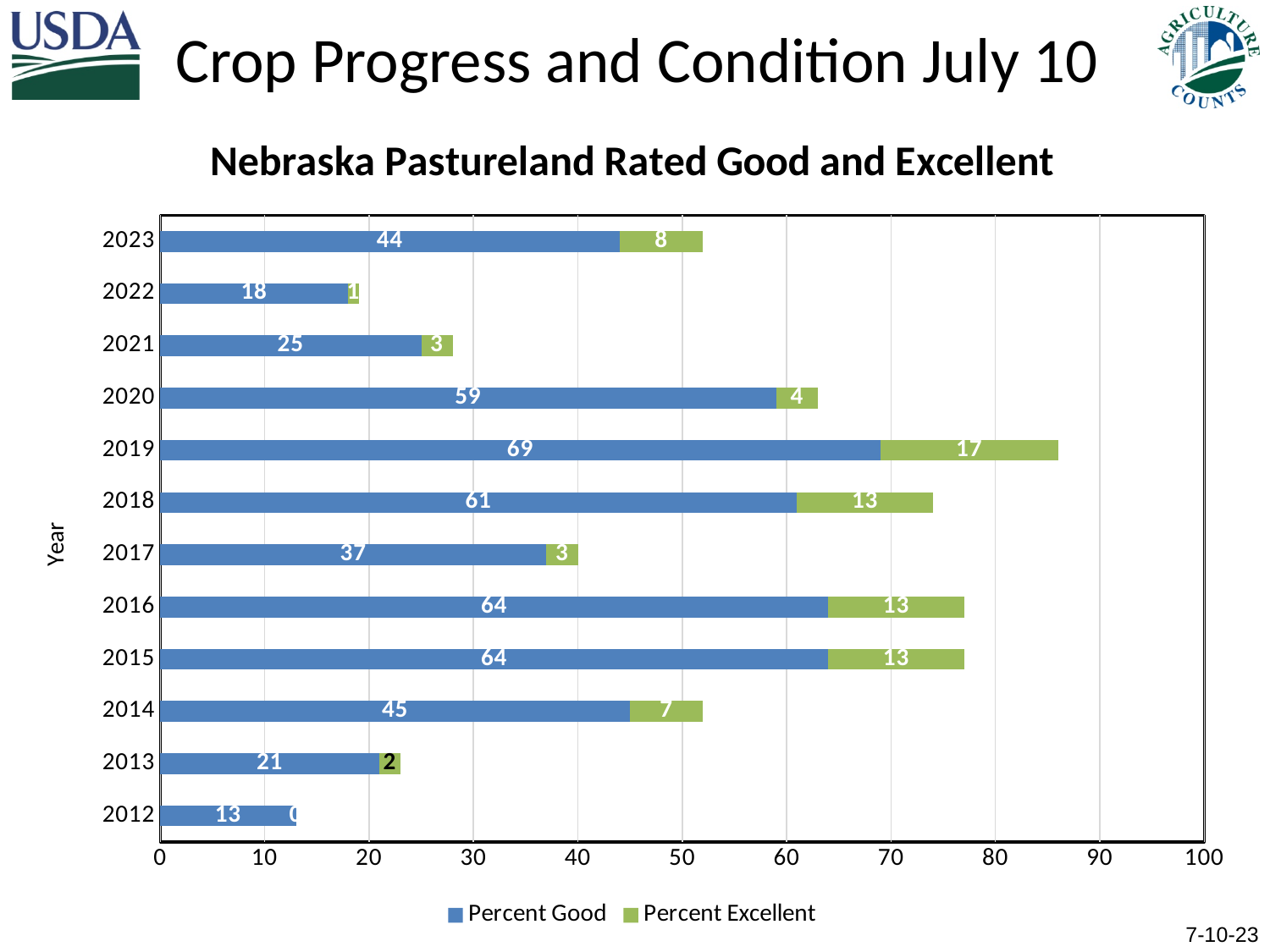
What kind of chart is shown on the slide? Stacked bar chart Which year has the highest Percent Good value? 2019 What is the total of the stacked bar for 2019 (Percent Good plus Percent Excellent)? 86 What is the difference between the Percent Good values for 2020 and 2021? 34 What is the Percent Good value for 2012? 13 How many series does the legend list? 2 What is the total of the stacked bar for 2016 (Percent Good plus Percent Excellent)? 77 Which is larger, the Percent Excellent value for 2019 or for 2023? 2019 What is the Percent Excellent value for 2018? 13 What is the Percent Good value for 2019? 69 Which year has the lowest Percent Good value? 2012 How many years are shown on the chart? 12